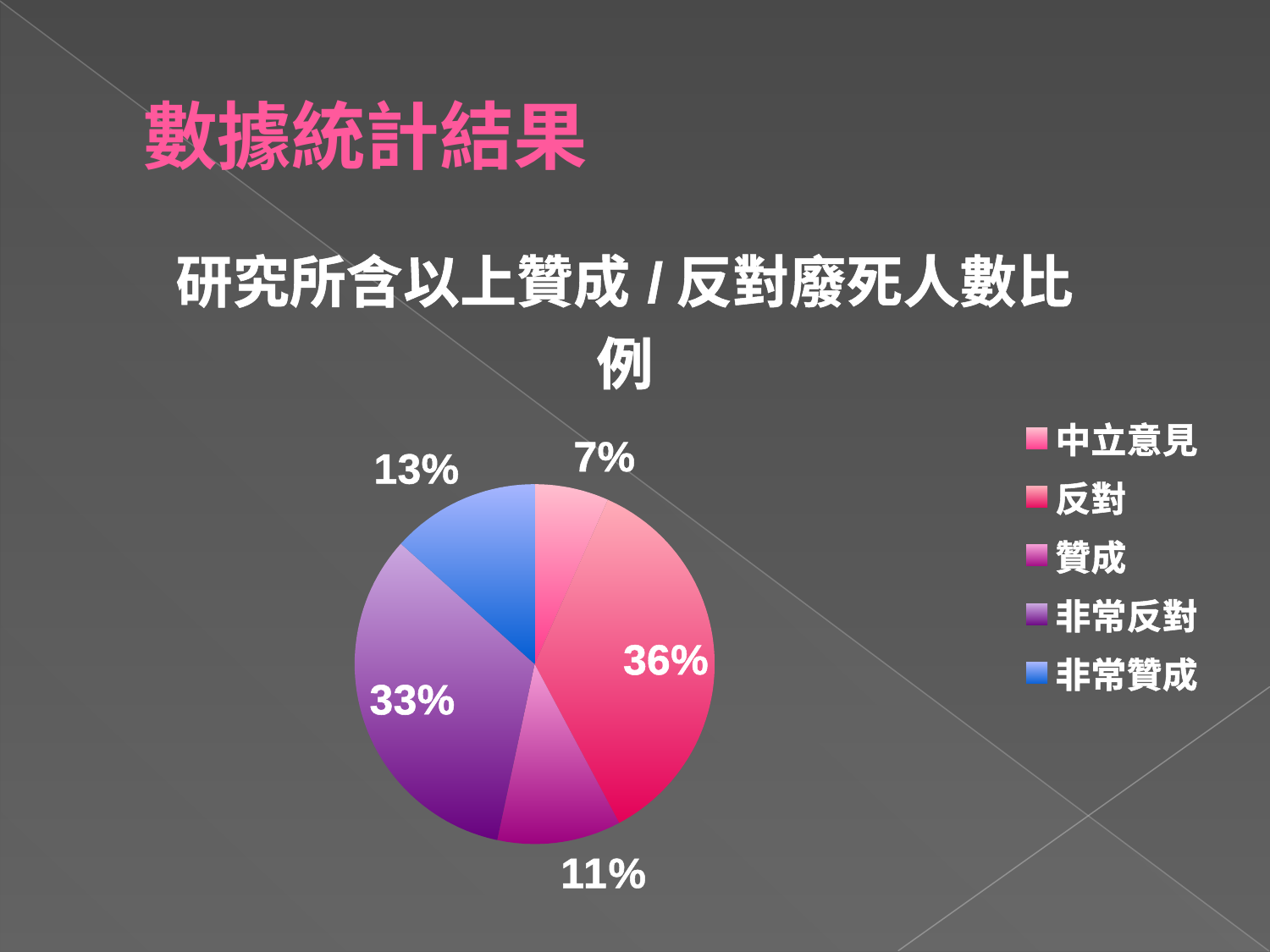
How many slices does the pie chart have? 5 What is the difference in percentage points between 反對 and 非常反對? 3 What is the share for 非常反對 in the pie chart? 33% Which is larger, the share for 非常贊成 or the share for 贊成? 非常贊成 Which category has the smallest slice of the pie chart? 中立意見 Which category has the largest slice of the pie chart? 反對 What is the share for 贊成 in the pie chart? 11% What kind of chart is shown on the slide? pie chart What is the title of the pie chart? 研究所含以上贊成 / 反對廢死人數比例 What is the share for 反對 in the pie chart? 36% What is the share for 中立意見 in the pie chart? 7% What is the share for 非常贊成 in the pie chart? 13%